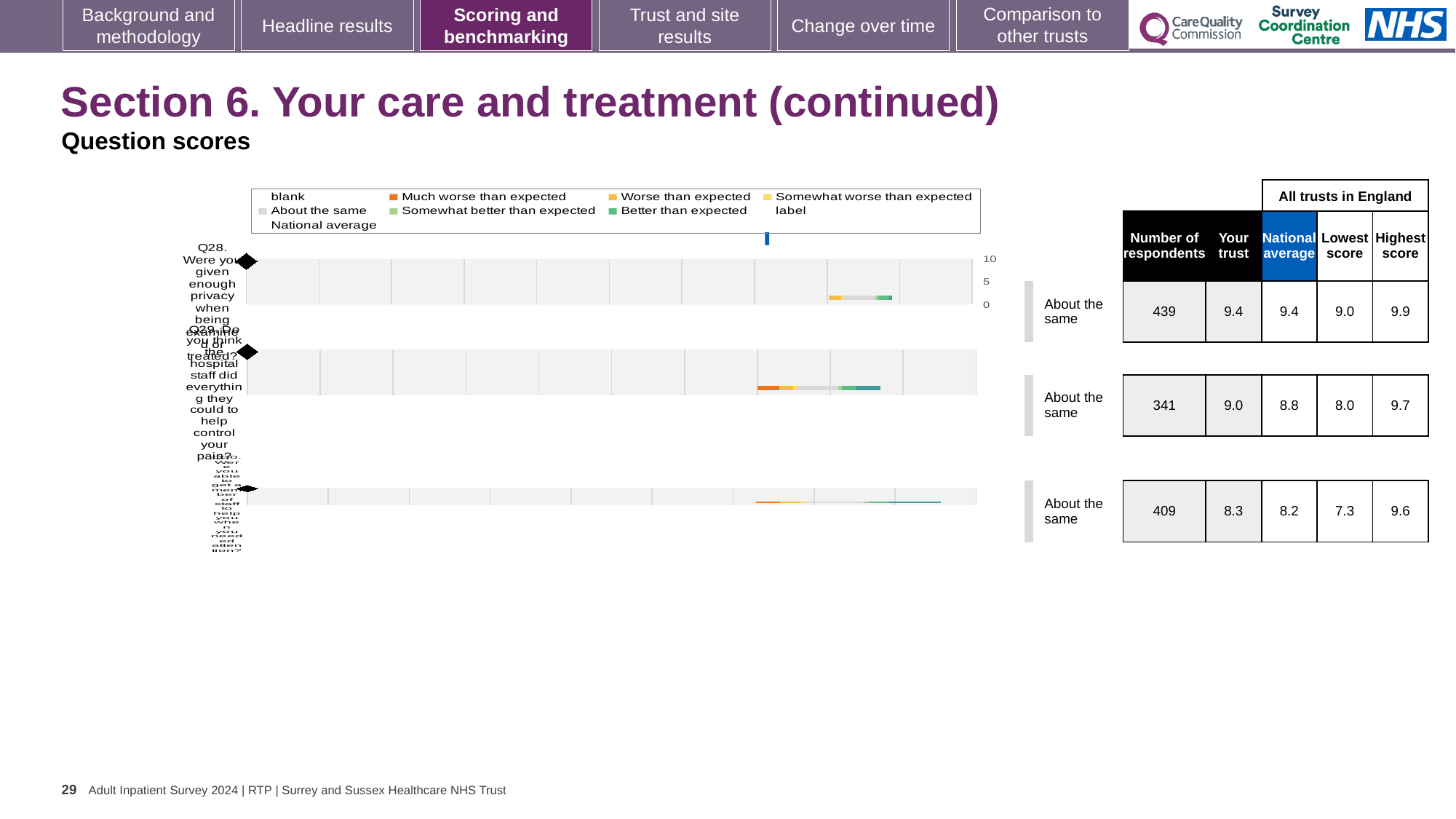
Which question row has the highest 'Your trust' score? Q28 What is the difference between the highest score and the lowest score for Q29? 1.7 How many respondents answered Q29 (Do you think the hospital staff did everything they could to help control your pain?)? 341 How many questions (rows) are plotted in the question scores chart? 3 Which question row has the fewest respondents? Q29 What is the 'Your trust' score for Q28 (Were you given enough privacy when being examined or treated?)? 9.4 What benchmark category is shown next to each of the three question rows? About the same What kind of chart is used to show the question scores on this slide? bar chart What is the national average score for Q29 (Do you think the hospital staff did everything they could to help control your pain?)? 8.8 Which is larger, the 'Your trust' score for Q28 or for Q29? Q28 What is the lowest score among all trusts in England for the third (bottom) question row? 7.3